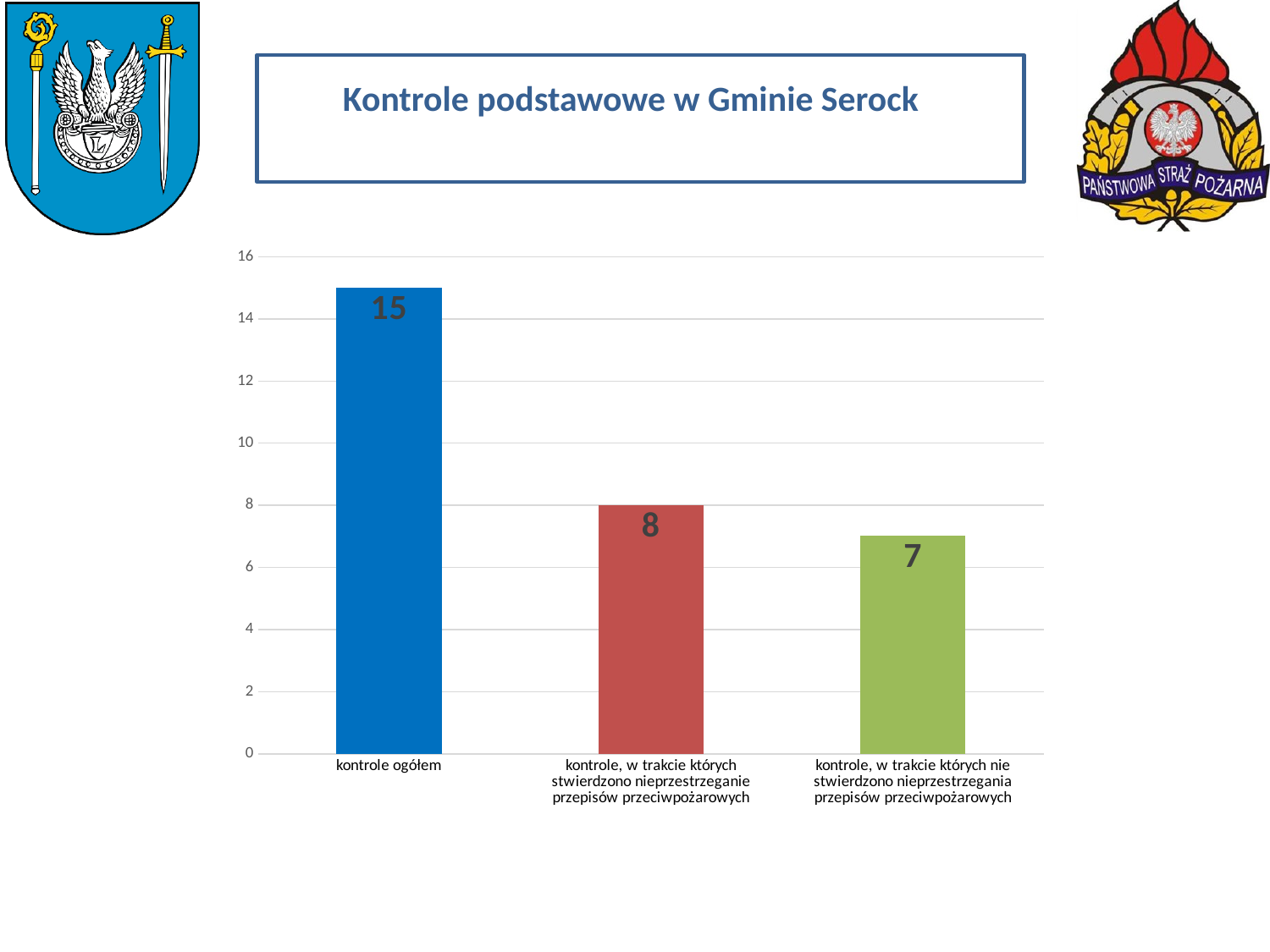
How many categories are shown in the chart? 3 What is the value for "kontrole, w trakcie których stwierdzono nieprzestrzeganie przepisów przeciwpożarowych"? 8 Which category has the lowest value? kontrole, w trakcie których nie stwierdzono nieprzestrzegania przepisów przeciwpożarowych Is the value for "kontrole ogółem" greater or less than 10? greater What is the title of the chart? Kontrole podstawowe w Gminie Serock Which category has the highest value? kontrole ogółem What is the value for "kontrole, w trakcie których nie stwierdzono nieprzestrzegania przepisów przeciwpożarowych"? 7 What is the difference between the value for "kontrole, w trakcie których stwierdzono nieprzestrzeganie przepisów przeciwpożarowych" and the value for "kontrole, w trakcie których nie stwierdzono nieprzestrzegania przepisów przeciwpożarowych"? 1 What is the difference between the value for "kontrole ogółem" and the value for "kontrole, w trakcie których stwierdzono nieprzestrzeganie przepisów przeciwpożarowych"? 7 What kind of chart is shown on the slide? bar chart Which is larger: the value for "kontrole ogółem" or the value for "kontrole, w trakcie których nie stwierdzono nieprzestrzegania przepisów przeciwpożarowych"? kontrole ogółem What is the value for "kontrole ogółem"? 15